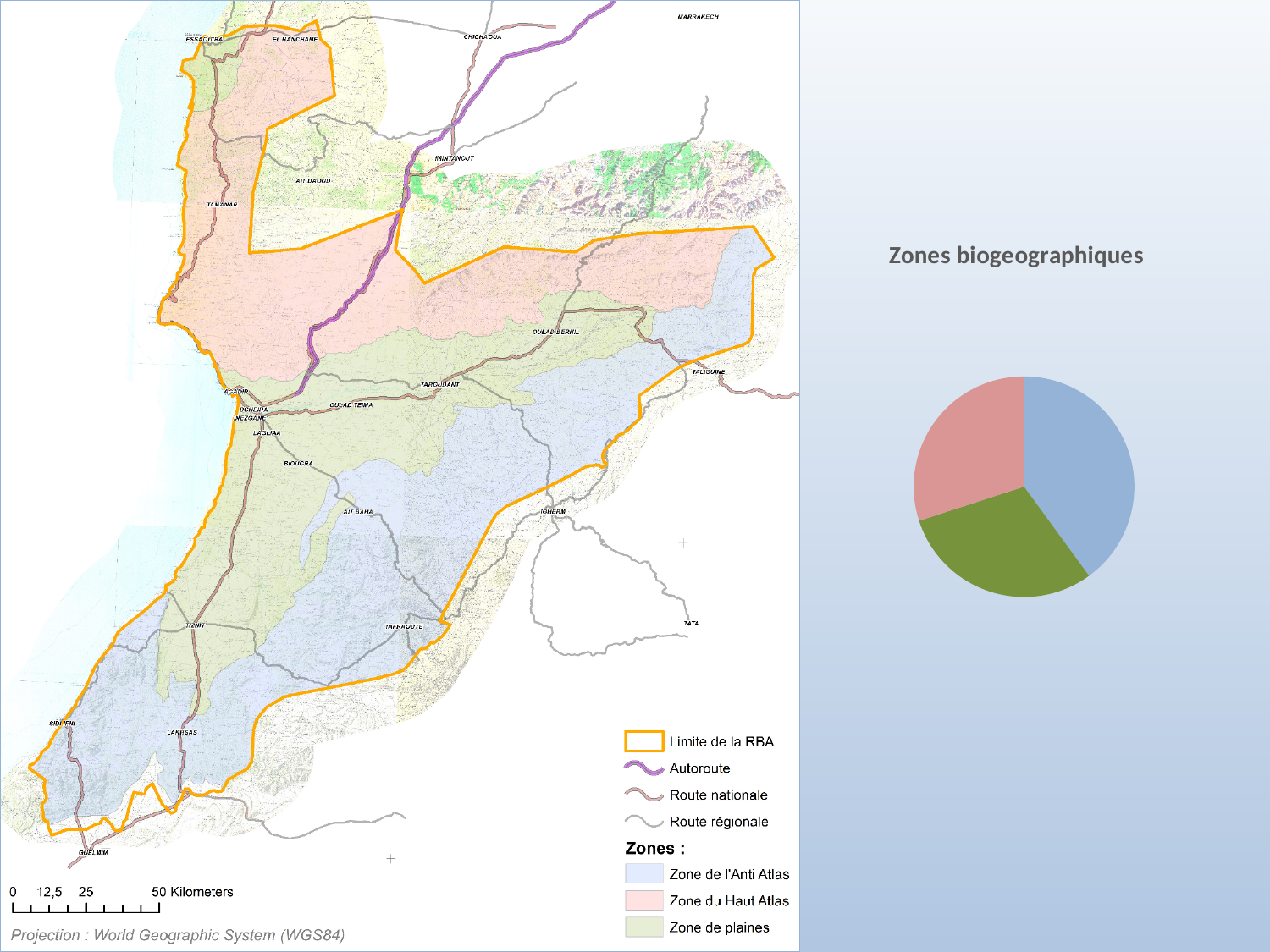
In the "Zones biogeographiques" pie chart, which colour slice is the largest? blue In the "Zones biogeographiques" pie chart, which is larger, the blue slice or the pink slice? blue What kind of chart is shown on the right side of the slide under the title "Zones biogeographiques"? pie chart How many slices does the "Zones biogeographiques" pie chart have? 3 What is the title of the chart on the right side of the slide? Zones biogeographiques Does the "Zones biogeographiques" pie chart display a legend? No